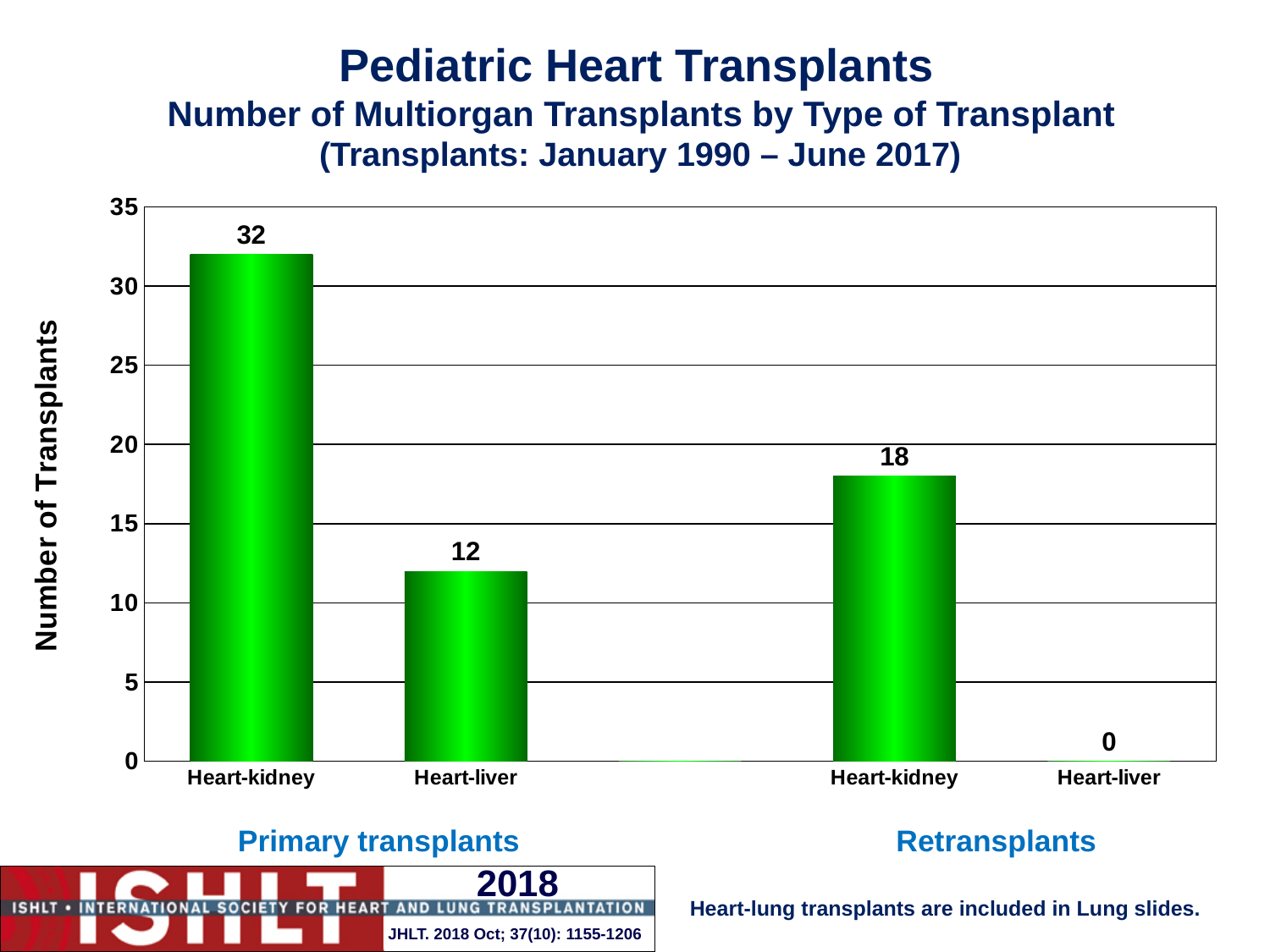
How many Heart-kidney retransplants are shown? 18 What kind of chart is shown on the slide? Bar chart How many Heart-liver retransplants are shown? 0 Which bar has the lowest number of transplants? Heart-liver (Retransplants) What is the difference between Heart-kidney and Heart-liver primary transplants? 20 Which is larger: Heart-liver primary transplants or Heart-kidney retransplants? Heart-kidney retransplants What is the difference between Heart-kidney primary transplants and Heart-kidney retransplants? 14 How many Heart-kidney primary transplants are shown? 32 How many bars (categories) are plotted on the chart? 4 What is the label of the y-axis? Number of Transplants How many Heart-liver primary transplants are shown? 12 Which bar has the highest number of transplants? Heart-kidney (Primary transplants)